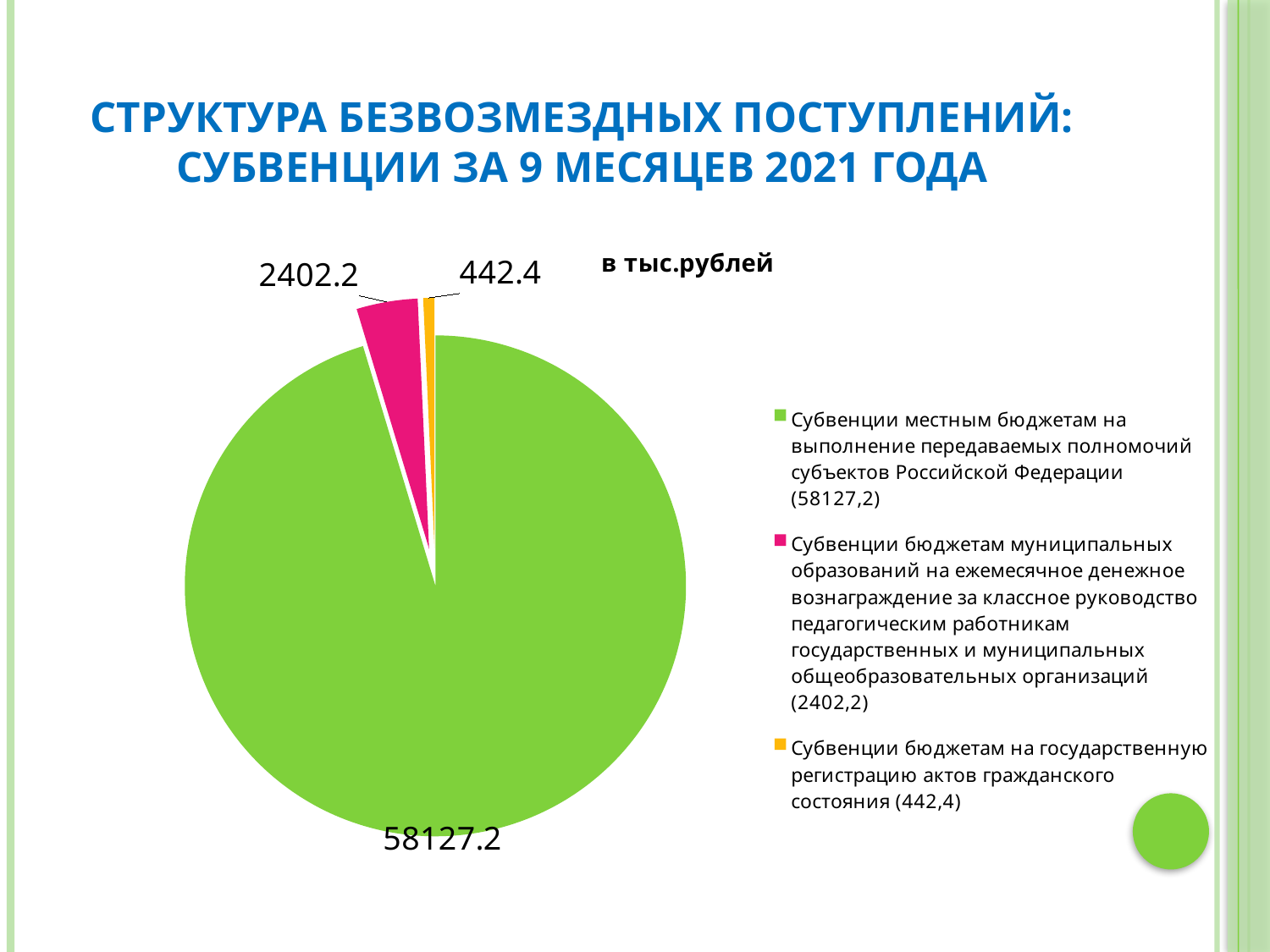
Which is larger: the slice for classroom leadership subventions or the slice for civil status registration subventions? classroom leadership subventions (2402.2) What is the value of the slice for 'Субвенции местным бюджетам на выполнение передаваемых полномочий субъектов Российской Федерации'? 58127.2 What is the difference between the value for classroom leadership subventions (2402.2) and the value for civil status registration subventions (442.4)? 1959.8 Which category has the largest slice of the pie? Субвенции местным бюджетам на выполнение передаваемых полномочий субъектов Российской Федерации How many slices does the pie chart have? 3 In what units are the values on the chart given, according to the slide? в тыс.рублей What is the value of the slice for 'Субвенции бюджетам на государственную регистрацию актов гражданского состояния'? 442.4 How many entries does the legend list? 3 Which category has the smallest slice of the pie? Субвенции бюджетам на государственную регистрацию актов гражданского состояния What type of chart is shown on the slide? pie chart What is the total of all three slices in the pie chart? 60971.8 What is the value of the slice for 'Субвенции бюджетам муниципальных образований на ежемесячное денежное вознаграждение за классное руководство'? 2402.2